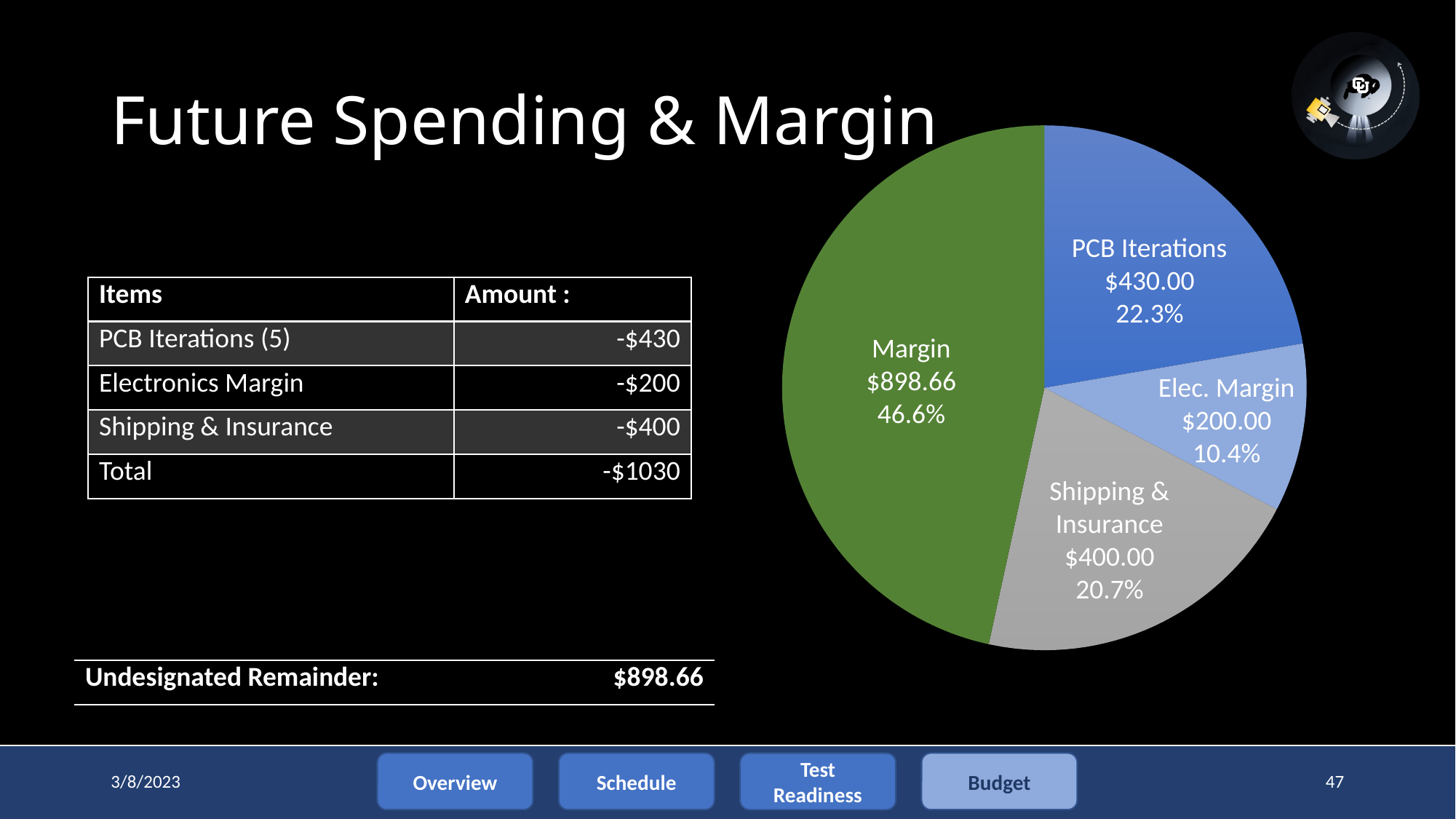
Which slice of the pie chart is the largest? Margin How many slices does the pie chart have? 4 What percentage share does the Elec. Margin slice have? 10.4% What colour is the Margin slice in the pie chart? green Which is larger, the PCB Iterations slice or the Shipping & Insurance slice? PCB Iterations What is the value shown for the Shipping & Insurance slice? $400.00 What is the difference in value between the PCB Iterations slice and the Elec. Margin slice? $230.00 What percentage share does the Shipping & Insurance slice have? 20.7% What type of chart is shown on the slide? pie chart What is the value shown for the Margin slice in the pie chart? $898.66 What percentage share does the PCB Iterations slice have in the pie chart? 22.3% Which slice of the pie chart is the smallest? Elec. Margin